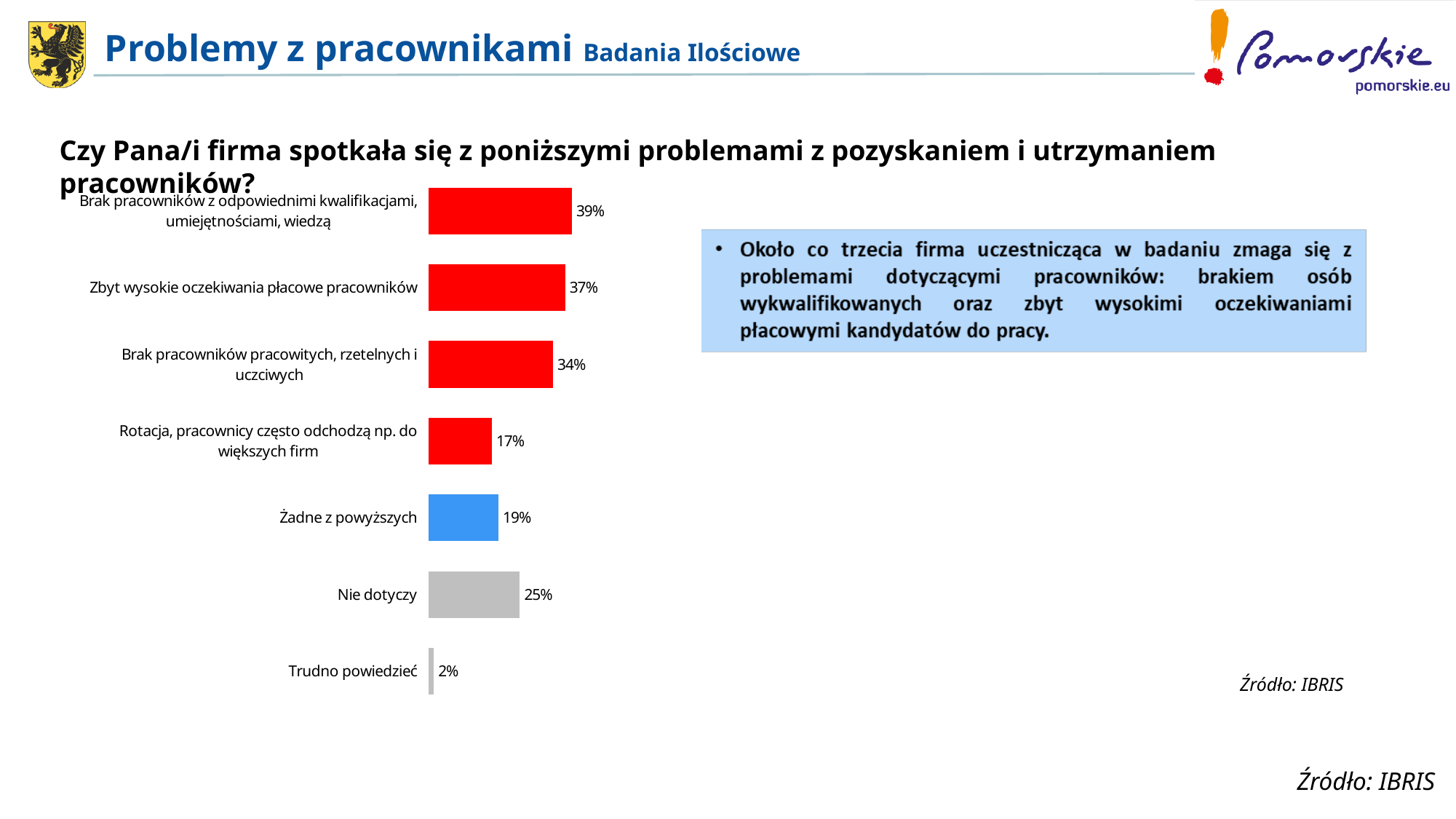
How many categories are shown in the chart? 7 What is the value for "Rotacja, pracownicy często odchodzą np. do większych firm"? 17% What is the value for "Nie dotyczy"? 25% What is the difference between "Brak pracowników pracowitych, rzetelnych i uczciwych" and "Rotacja, pracownicy często odchodzą np. do większych firm"? 17% What percentage of firms reported "Brak pracowników z odpowiednimi kwalifikacjami, umiejętnościami, wiedzą"? 39% What is the value for "Zbyt wysokie oczekiwania płacowe pracowników"? 37% Which category has the highest value? Brak pracowników z odpowiednimi kwalifikacjami, umiejętnościami, wiedzą Which is larger: "Żadne z powyższych" or "Nie dotyczy"? Nie dotyczy What colour is the bar for "Żadne z powyższych"? Blue What is the difference between "Brak pracowników z odpowiednimi kwalifikacjami, umiejętnościami, wiedzą" and "Zbyt wysokie oczekiwania płacowe pracowników"? 2% Which category has the lowest value? Trudno powiedzieć What kind of chart is shown on the slide? Bar chart